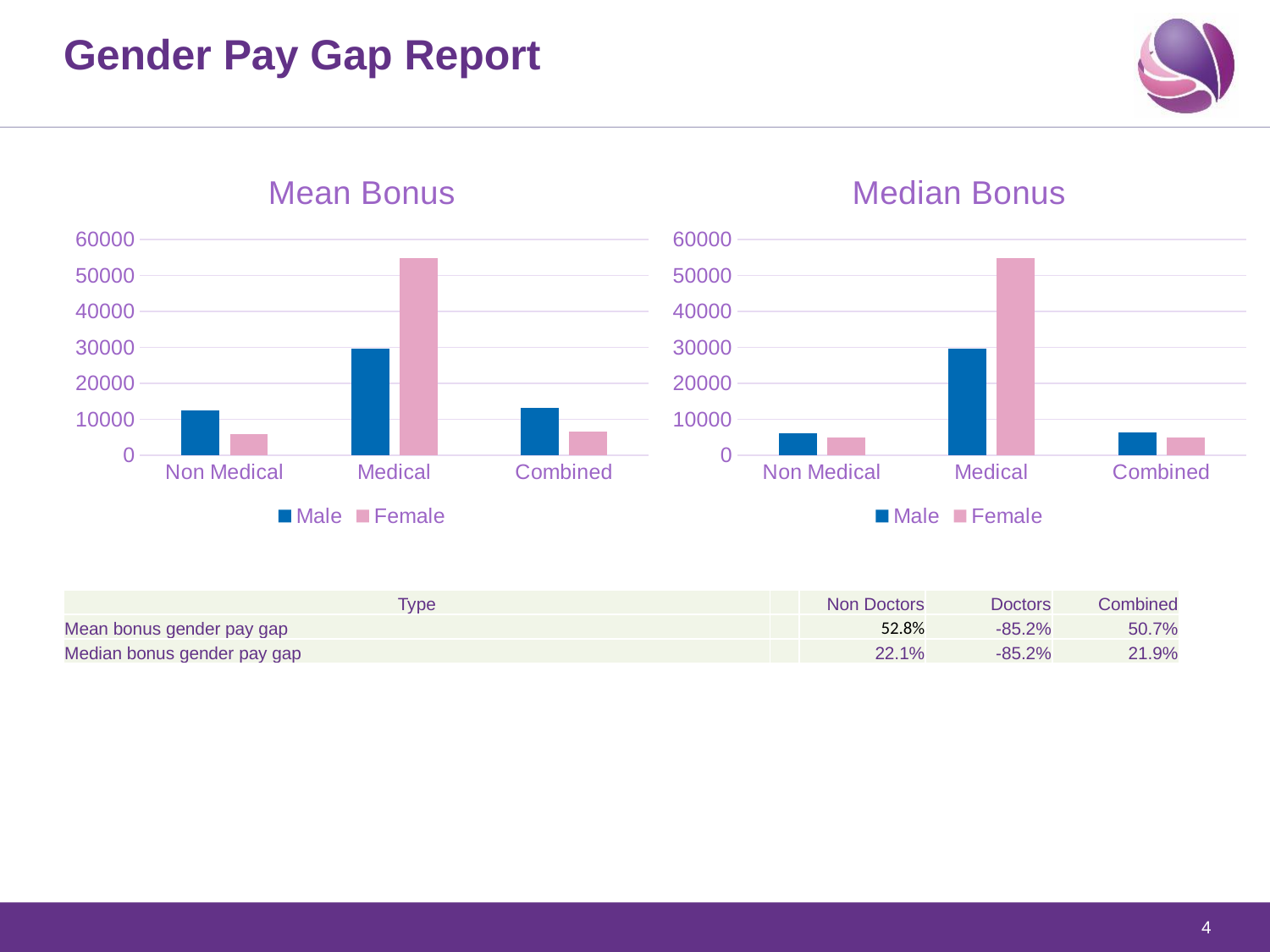
In the Median Bonus chart, which is larger for Medical, the Male value or the Female value? Female In the Mean Bonus chart, which category has the lowest Female value? Non Medical In the Median Bonus chart, how many categories are shown on the x axis? 3 In the Median Bonus chart, which category has the highest Male value? Medical In the Mean Bonus chart, what kind of chart is shown? bar chart In the Mean Bonus chart, how many series does the legend list? 2 In the Median Bonus chart, what are the two legend entries? Male and Female In the Mean Bonus chart, which is larger for Non Medical, the Male value or the Female value? Male In the Mean Bonus chart, is the Male value for Non Medical greater or less than 10000? greater In the Mean Bonus chart, is the Female value for Medical greater or less than 50000? greater In the Mean Bonus chart, which category has the highest Female value? Medical In the Median Bonus chart, is the Male value for Non Medical greater or less than 10000? less